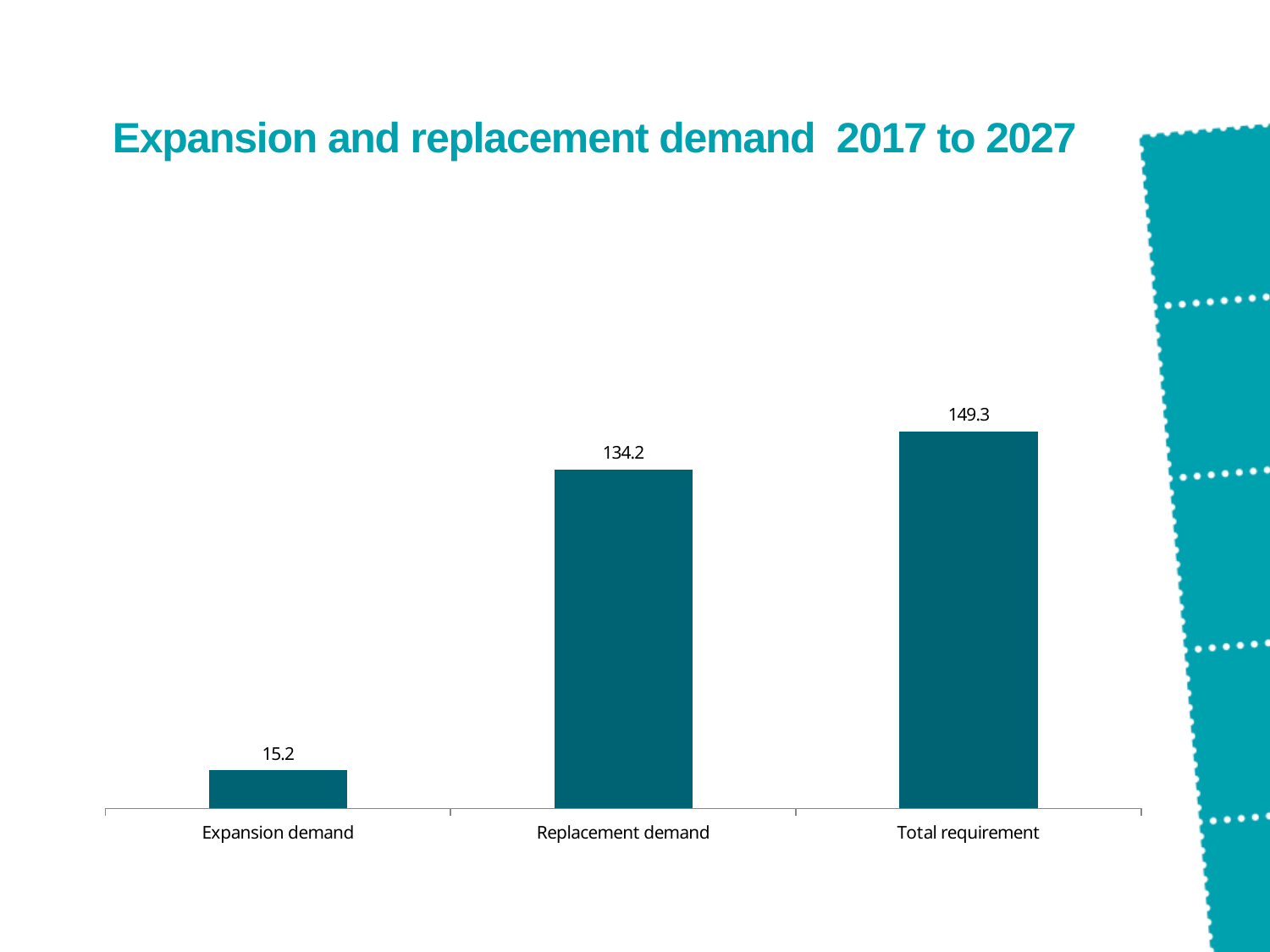
Which is larger, Replacement demand or Expansion demand? Replacement demand How many categories are shown on the chart? 3 Which category has the highest value? Total requirement Do the values rise or fall from left to right across the categories? Rise What is the value for Total requirement? 149.3 What is the value for Expansion demand? 15.2 What is the difference between Total requirement and Replacement demand? 15.1 Which category has the lowest value? Expansion demand What is the value for Replacement demand? 134.2 What kind of chart is shown on the slide? Bar chart What is the title of the slide? Expansion and replacement demand 2017 to 2027 What is the difference between Replacement demand and Expansion demand? 119.0